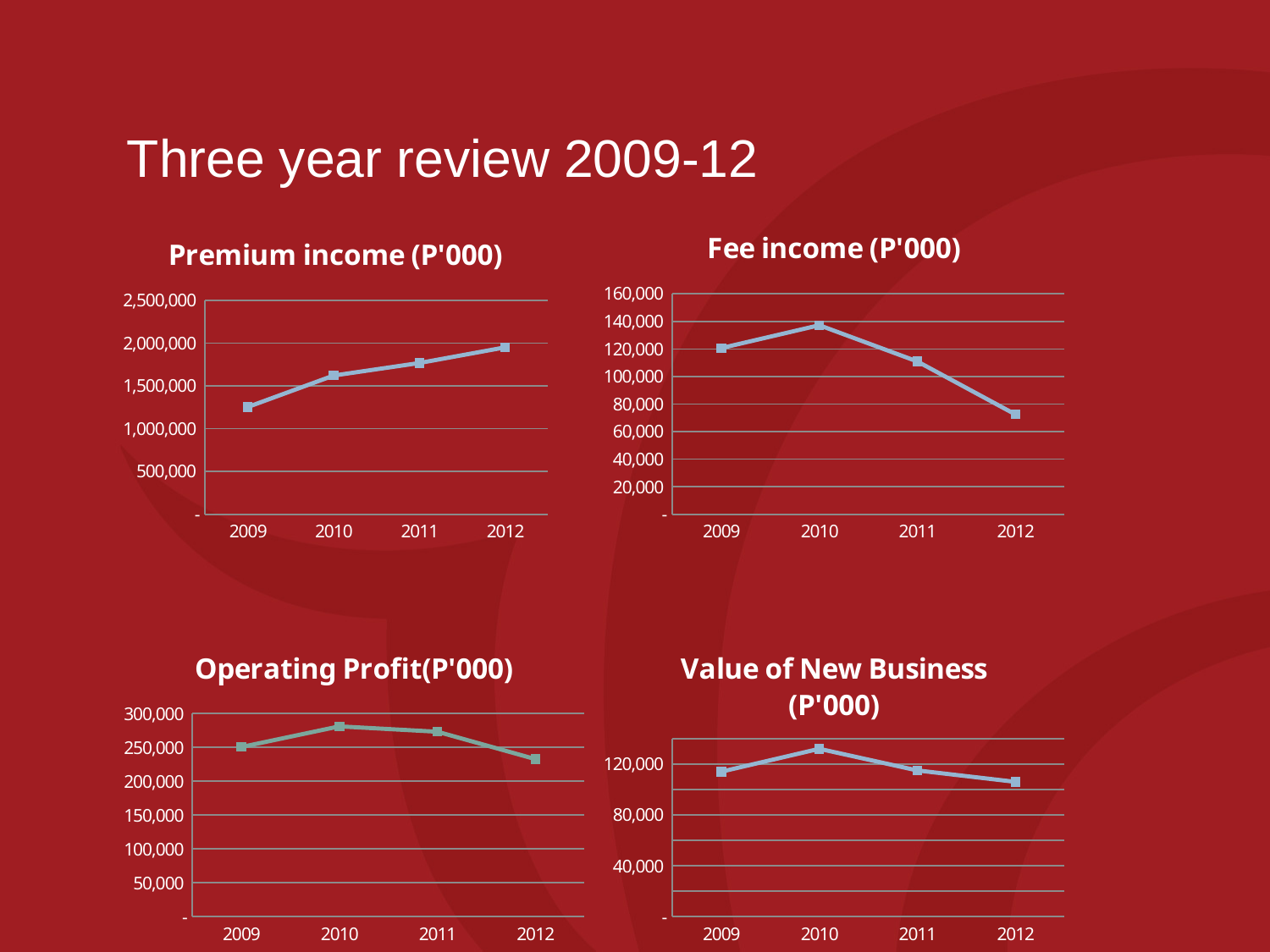
What kind of chart is the "Premium income (P'000)" chart? line chart In the "Premium income (P'000)" chart, do the values rise or fall from 2009 to 2012? rise In the "Fee income (P'000)" chart, which year has the highest value? 2010 In the "Fee income (P'000)" chart, which year has the lowest value? 2012 In the "Operating Profit(P'000)" chart, which year has the lowest value? 2012 In the "Premium income (P'000)" chart, how many years are plotted on the x axis? 4 In the "Value of New Business (P'000)" chart, which year has the highest value? 2010 In the "Fee income (P'000)" chart, is the value for 2012 greater or less than 80,000? less How many charts are shown on the slide? 4 In the "Premium income (P'000)" chart, which year has the highest value? 2012 In the "Fee income (P'000)" chart, which year has the larger value, 2009 or 2012? 2009 In the "Premium income (P'000)" chart, is the value for 2009 greater or less than 1,500,000? less